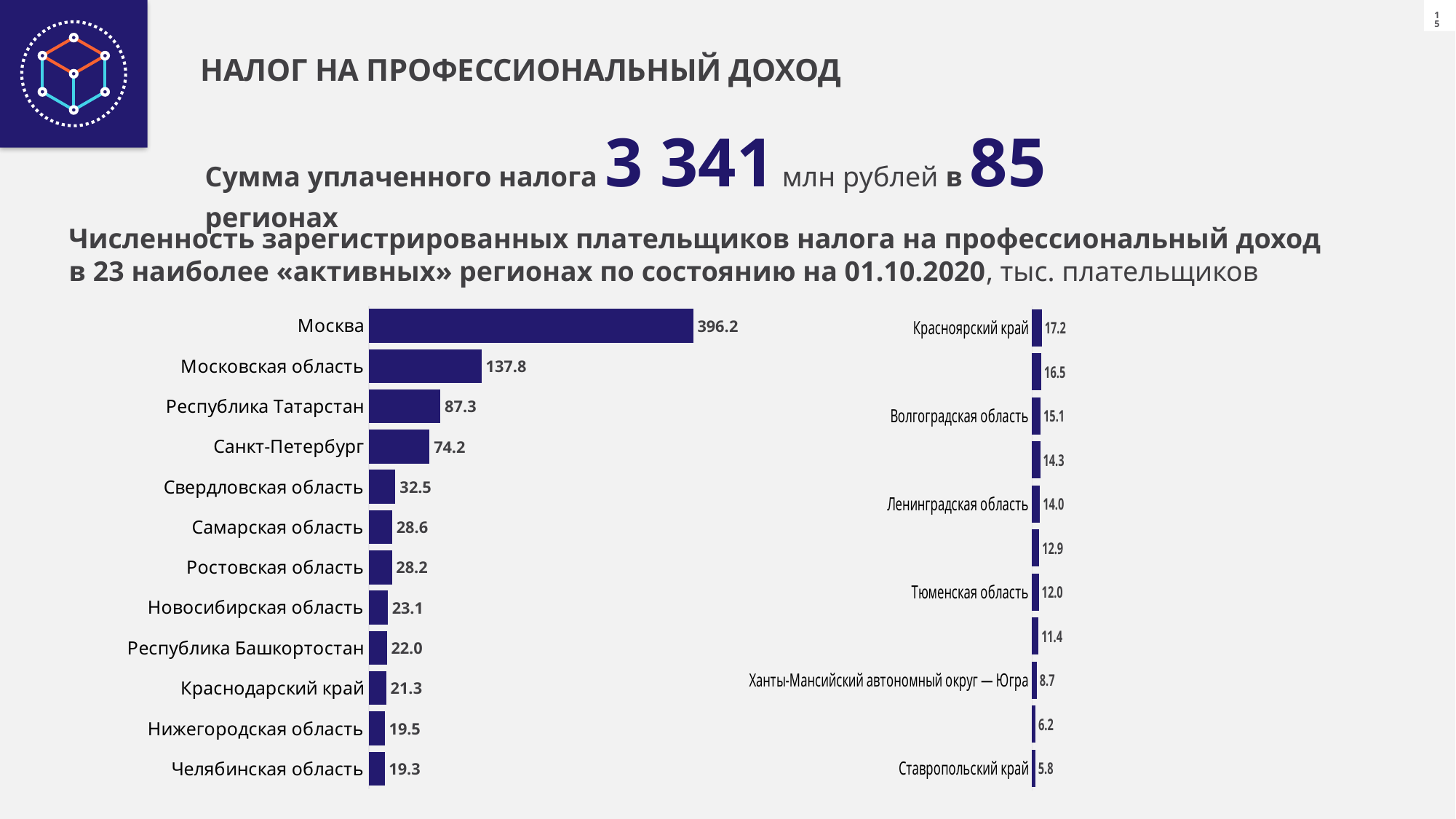
On the left chart, which is larger: the value for Санкт-Петербург or the value for Свердловская область? Санкт-Петербург On the right chart, what is the difference between the values for Волгоградская область and Ленинградская область? 1.1 On the right chart, what is the value for Ханты-Мансийский автономный округ — Югра? 8.7 On the left chart, what is the difference between the values for Москва and Московская область? 258.4 On the left chart, which region has the highest value? Москва What kind of chart is the left chart? bar chart On the right chart, which is larger: the value for Тюменская область or the value for Ставропольский край? Тюменская область On the left chart, what is the value for Москва? 396.2 How many bars are shown on the left chart? 12 On the right chart, what is the value for Красноярский край? 17.2 On the left chart, which region has the lowest value? Челябинская область On the left chart, what is the value for Республика Татарстан? 87.3